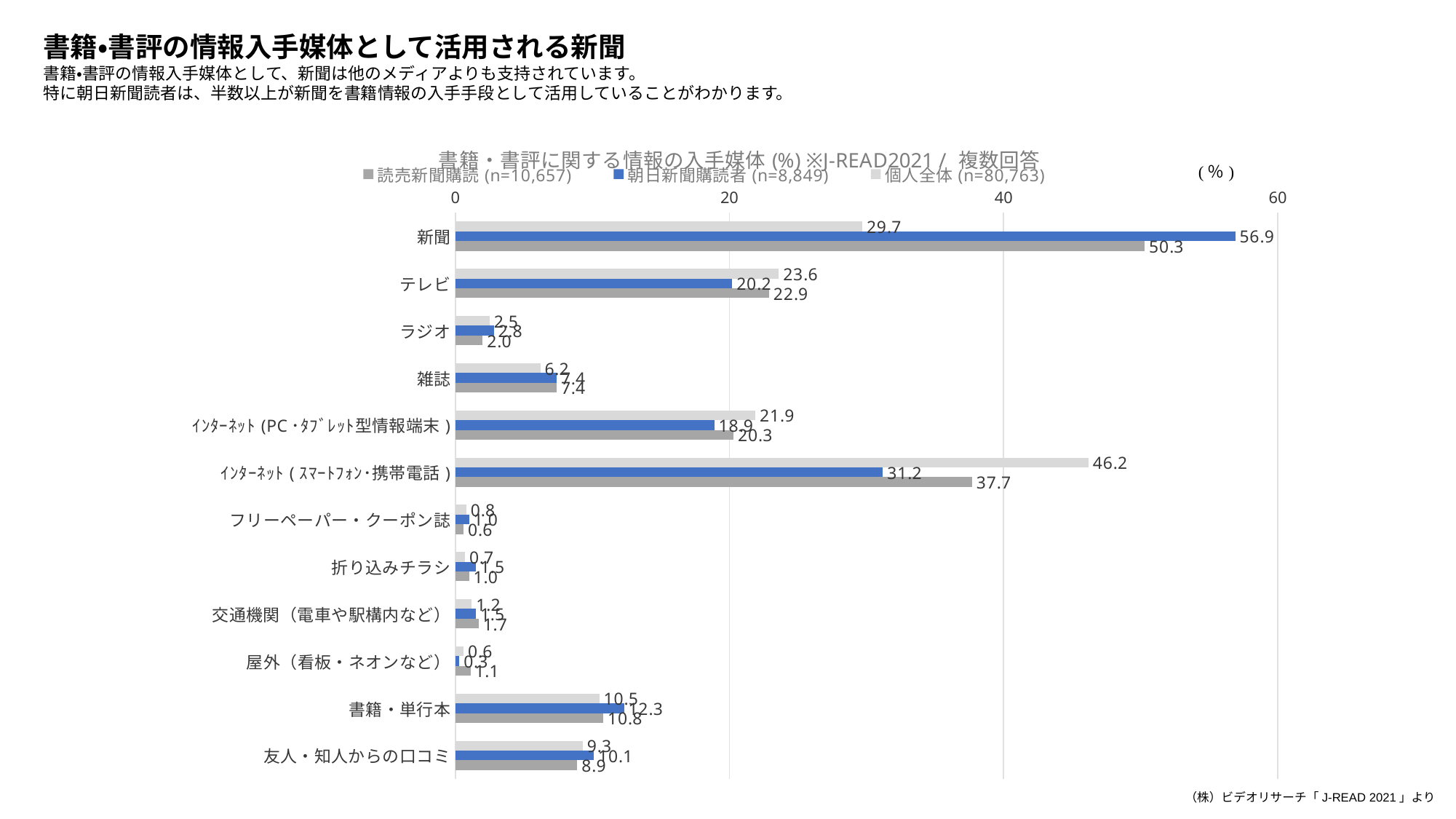
What is the value for 朝日新聞購読者 for 新聞? 56.9 How many series does the legend list? 3 Which category has the highest value for 個人全体? インターネット（スマートフォン・携帯電話） For 書籍・単行本, which is larger: the 朝日新聞購読者 value or the 読売新聞購読 value? 朝日新聞購読者 What is the value for 読売新聞購読 for テレビ? 22.9 Which category has the highest value for 朝日新聞購読者? 新聞 Is the 読売新聞購読 value for インターネット（スマートフォン・携帯電話） greater or less than 40? less How many categories (media) are shown on the vertical axis? 12 Which series is drawn in blue? 朝日新聞購読者 (n=8,849) What is the value for 個人全体 for インターネット（スマートフォン・携帯電話）? 46.2 What type of chart is shown on the slide? bar chart What is the difference between the 朝日新聞購読者 and 個人全体 values for 新聞? 27.2